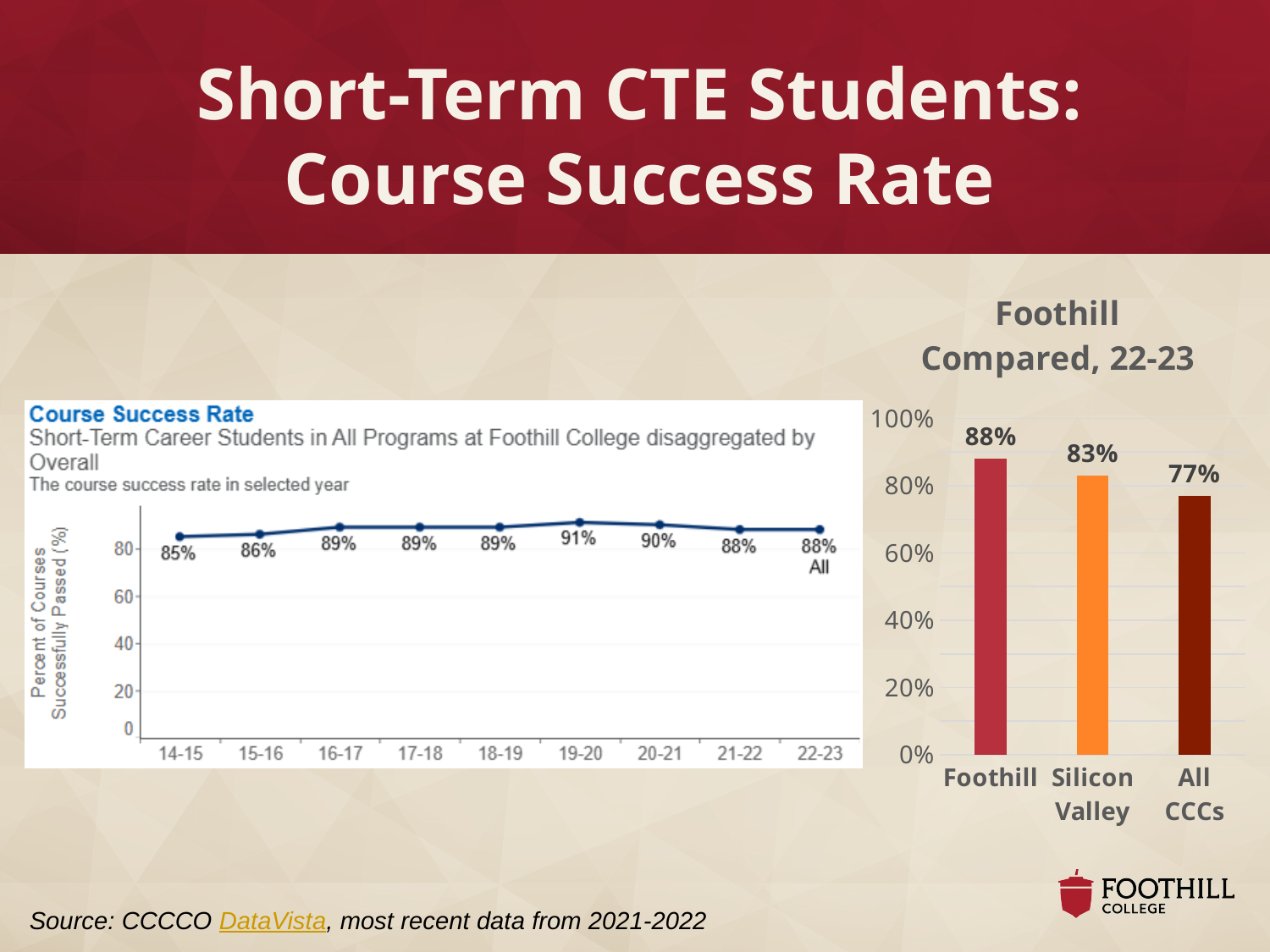
In the 'Course Success Rate' line chart, what is the difference between the 19-20 and 14-15 course success rates? 6% In the 'Foothill Compared, 22-23' chart, what is the difference between Foothill and All CCCs? 11% In the 'Course Success Rate' line chart, what is the course success rate for 14-15? 85% In the 'Course Success Rate' line chart, how many years are plotted on the x axis? 9 What kind of chart is the 'Foothill Compared, 22-23' chart on the right? Bar chart What kind of chart is the 'Course Success Rate' chart on the left? Line chart In the 'Course Success Rate' line chart, which year has the lowest course success rate? 14-15 In the 'Foothill Compared, 22-23' chart, which is larger, Foothill or Silicon Valley? Foothill In the 'Foothill Compared, 22-23' chart, which category has the lowest value? All CCCs In the 'Foothill Compared, 22-23' chart, what is the value for Silicon Valley? 83% In the 'Course Success Rate' line chart, what is the course success rate for 19-20? 91% In the 'Course Success Rate' line chart, which year has the highest course success rate? 19-20